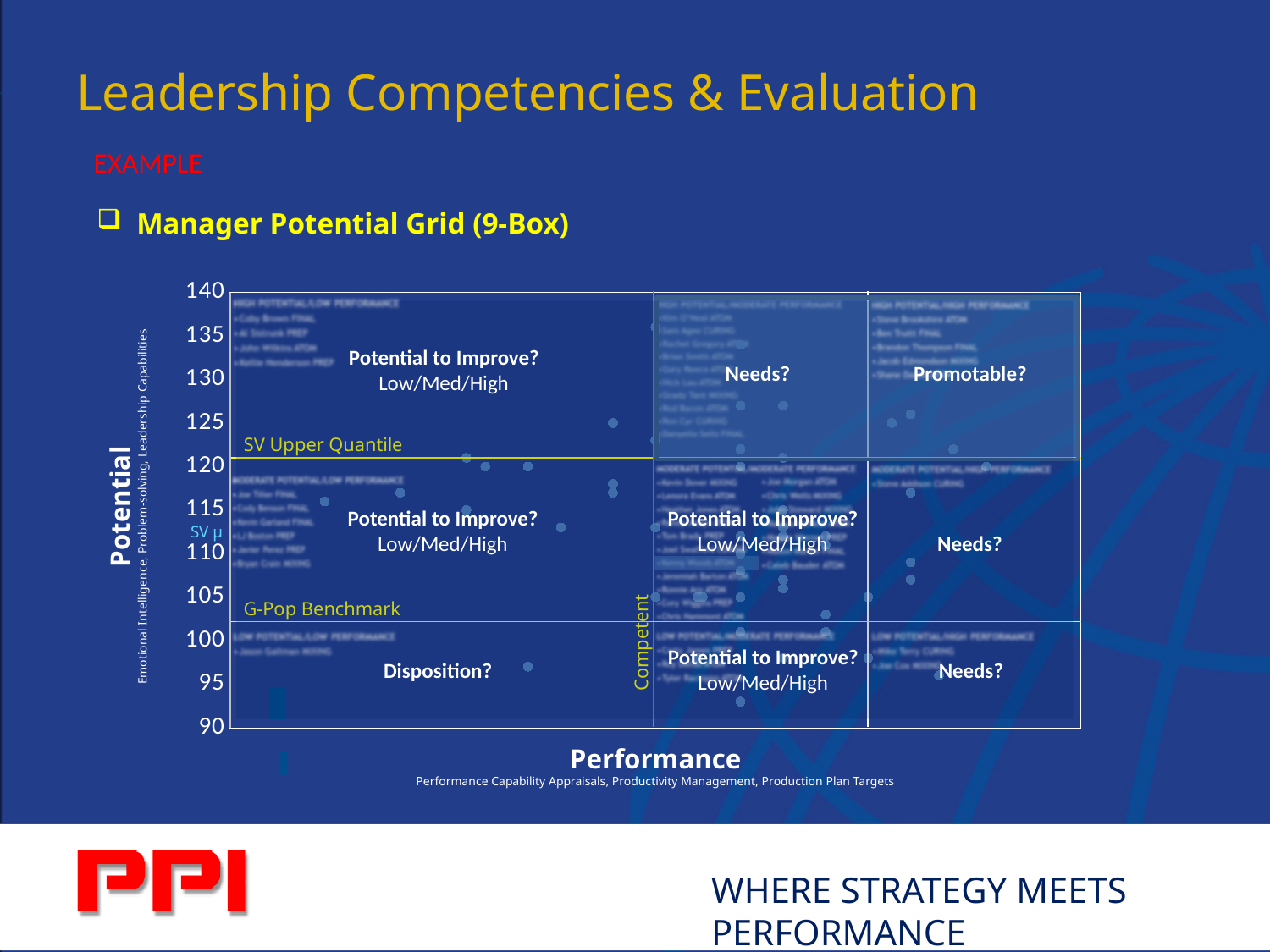
What kind of chart is the Manager Potential Grid (9-Box)? scatter chart What is the lowest value shown on the Potential (vertical) axis? 90 Into how many boxes is the Manager Potential Grid divided? 9 Which box label appears in the top-right (high potential, high performance) cell of the grid? Promotable? Is the SV Upper Quantile line above or below the G-Pop Benchmark line on the Potential axis? above At what Potential value is the SV Upper Quantile line drawn on the grid? 120 What is the label of the horizontal axis of the grid? Performance What is the highest value shown on the Potential (vertical) axis? 140 At what Potential value is the G-Pop Benchmark line drawn on the grid? 100